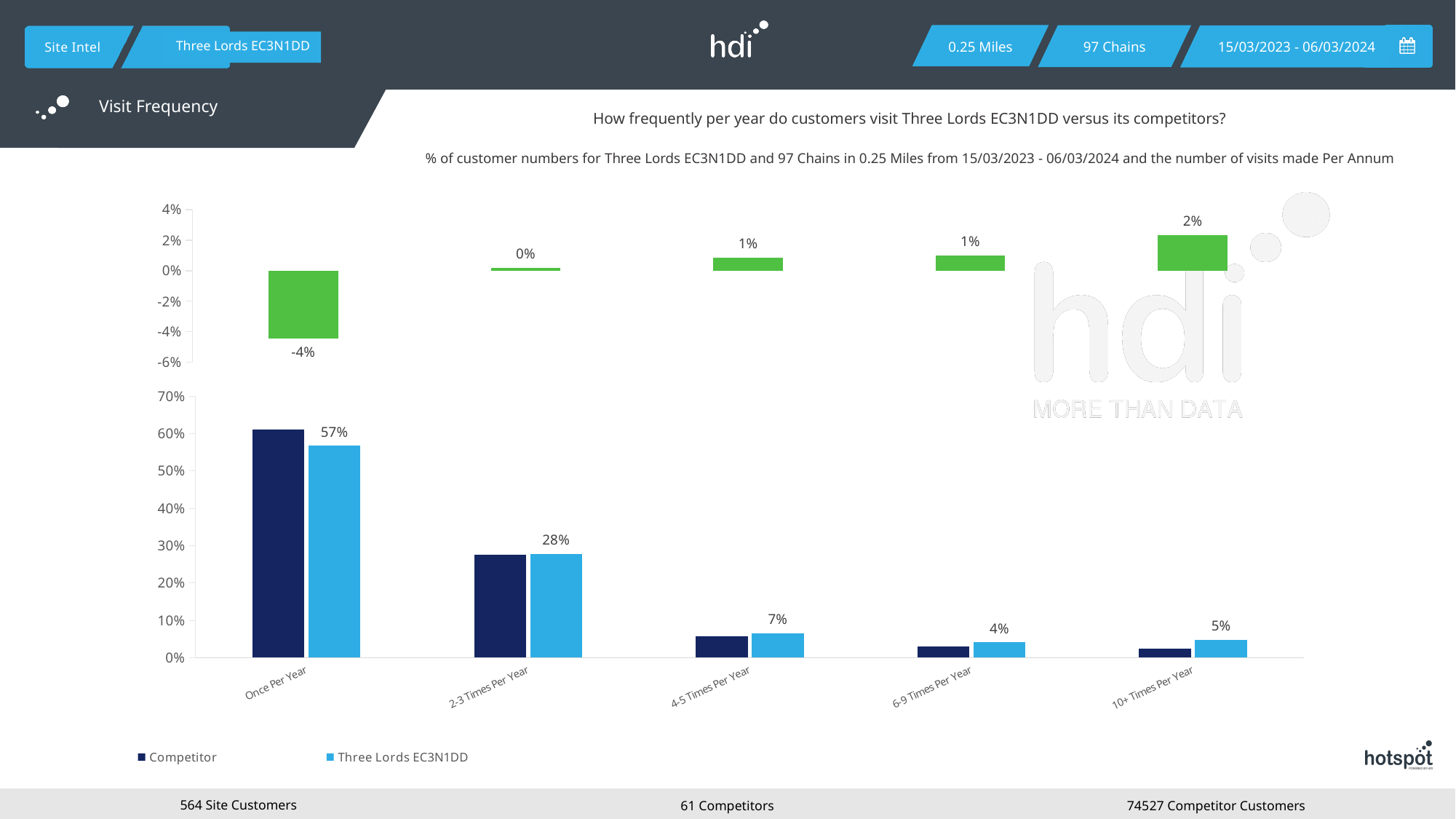
In the bottom chart, which category has the lowest value for Three Lords EC3N1DD? 6-9 Times Per Year In the bottom chart, which category has the highest value for Three Lords EC3N1DD? Once Per Year In the bottom chart, what is the difference between the Three Lords EC3N1DD values for Once Per Year and 2-3 Times Per Year? 29% In the bottom chart, what is the value for Three Lords EC3N1DD in the 2-3 Times Per Year category? 28% In the bottom chart, what is the value for Three Lords EC3N1DD in the 10+ Times Per Year category? 5% In the top chart, what is the value shown for the 10+ Times Per Year category? 2% In the bottom chart, which is larger in the Once Per Year category: Competitor or Three Lords EC3N1DD? Competitor How many series does the legend of the bottom chart list? 2 In the bottom chart, is the Competitor value for Once Per Year greater or less than 50%? greater How many categories are shown on the x axis of the bottom chart? 5 In the bottom chart, what is the value for Three Lords EC3N1DD in the Once Per Year category? 57% In the top chart, what is the value shown for the Once Per Year category? -4%